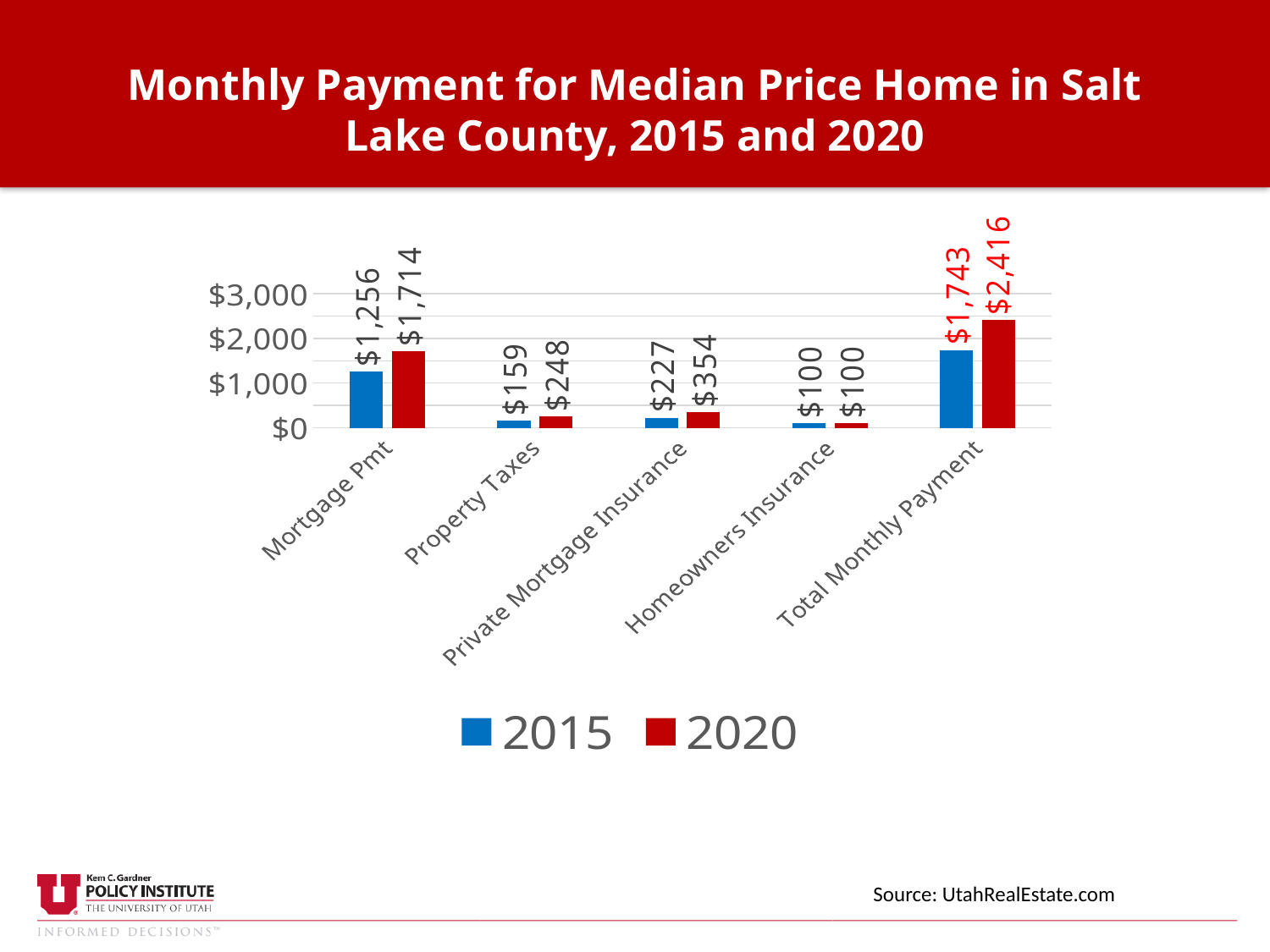
What was the Property Taxes value in 2015? $159 What kind of chart is shown on the slide? Bar chart How many categories are shown on the x axis? 5 What was the Mortgage Pmt value in 2020? $1,714 What is the difference between the 2020 and 2015 Mortgage Pmt values? $458 What was the Total Monthly Payment in 2015? $1,743 Which is larger, Property Taxes in 2020 or Private Mortgage Insurance in 2015? Property Taxes in 2020 What was the Private Mortgage Insurance value in 2020? $354 Which category has the highest value for 2020? Total Monthly Payment How many series does the legend list? 2 What is the difference between the 2020 and 2015 Total Monthly Payment? $673 Which category has the lowest value for 2015? Homeowners Insurance